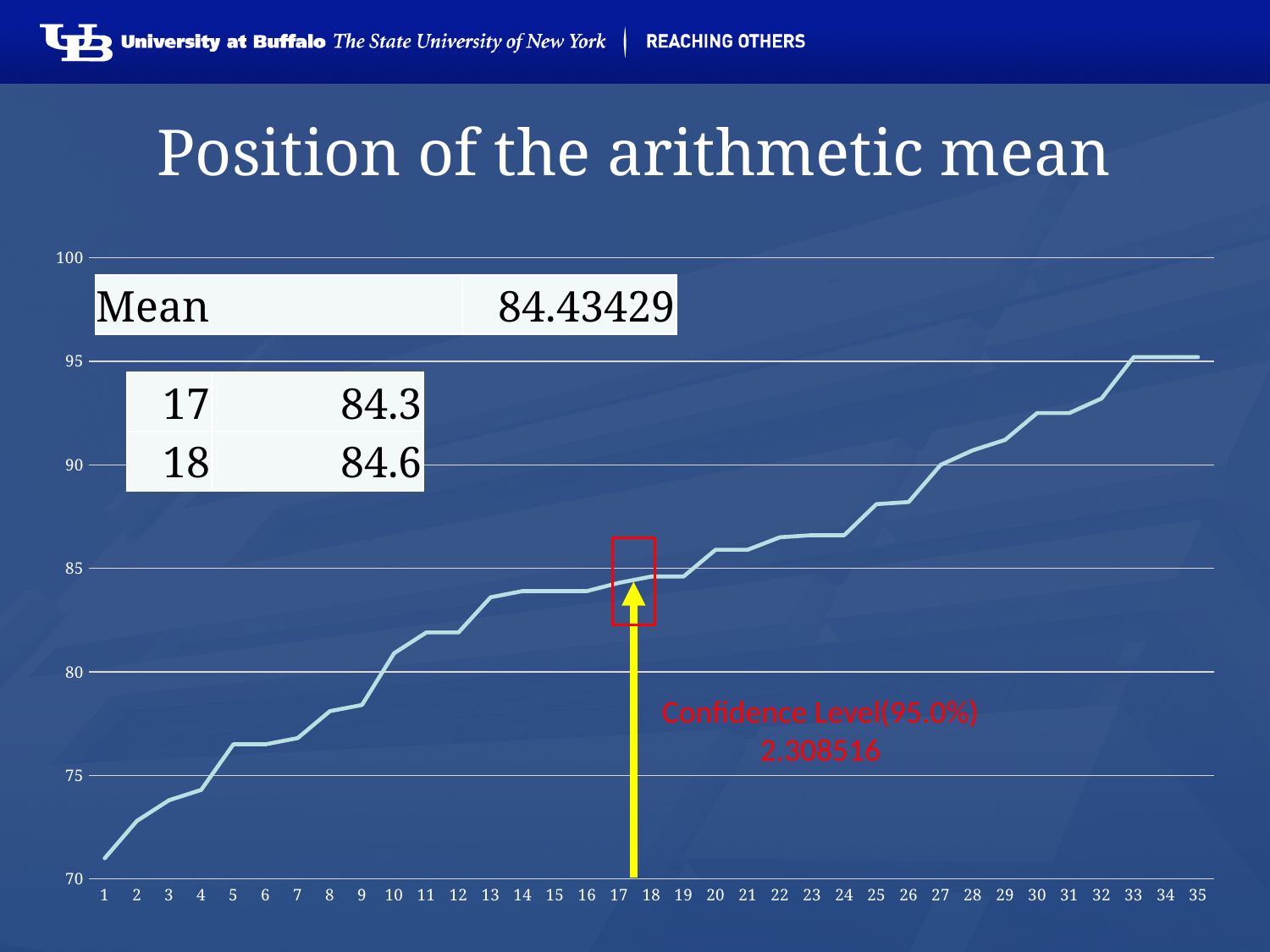
What is the title of the chart? Position of the arithmetic mean Do the values rise or fall as you move from point 1 to point 35? rise What is the value at point 18 according to the table on the chart? 84.6 What is the value at point 17 according to the table on the chart? 84.3 What is the difference between the values at points 18 and 17? 0.3 What mean value is printed on the chart? 84.43429 Is the value at point 30 greater or less than 90? greater What kind of chart is shown on the slide? line chart Which point has the lowest value? 1 Is the value at point 1 greater or less than 75? less How many points are plotted along the x axis? 35 Which has the larger value, point 10 or point 30? point 30